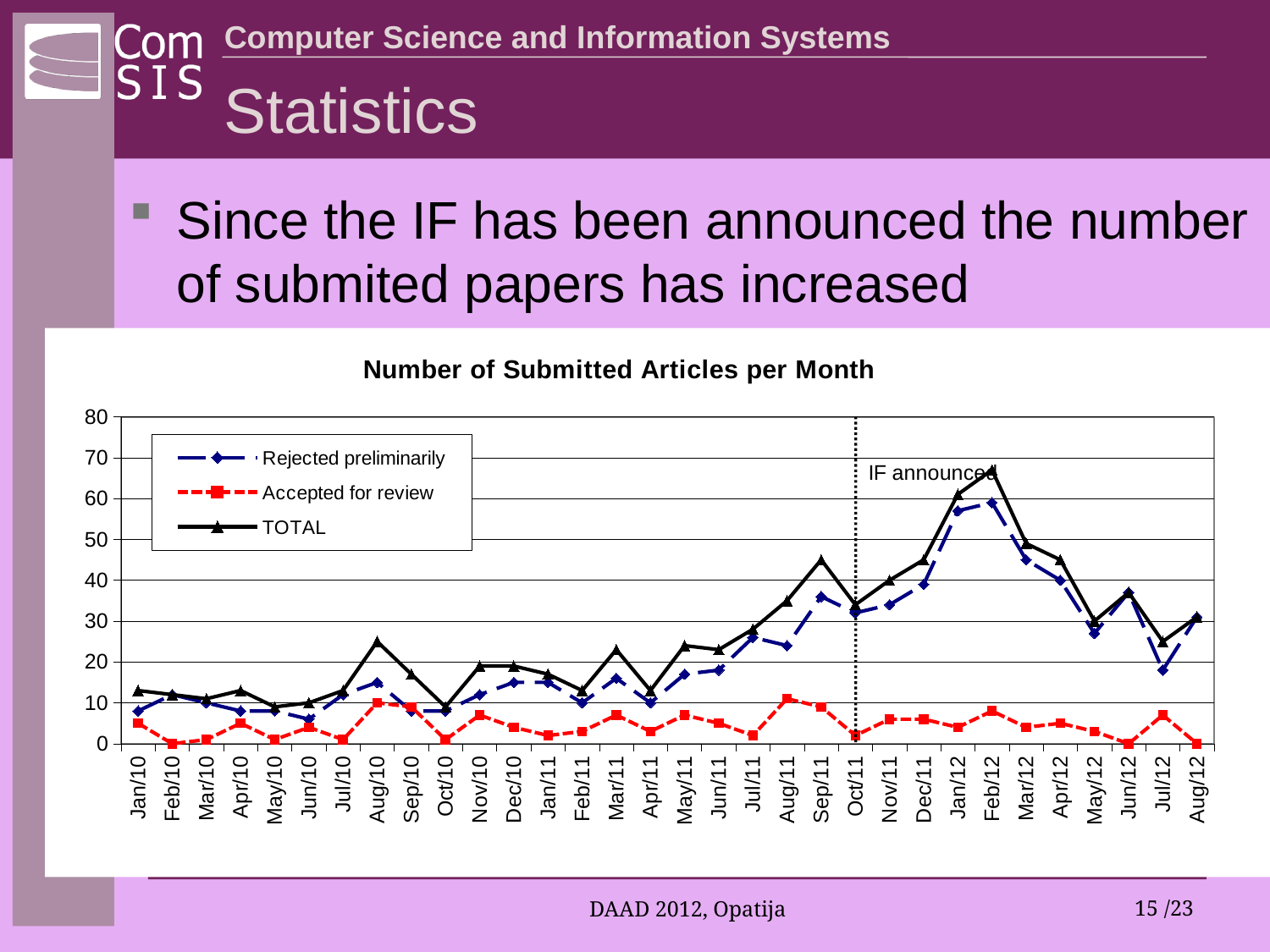
What is the title of the chart? Number of Submitted Articles per Month Is the Rejected preliminarily value for Jan/12 greater or less than 50? greater What kind of chart is shown on the slide? Line chart At which month is the vertical dotted line labelled 'IF announced' placed? Oct/11 Does the TOTAL series rise or fall from Oct/11 to Feb/12? rise Is the Accepted for review value for Feb/12 greater or less than 10? less Is the TOTAL value for Feb/12 greater or less than 60? greater How many series does the chart's legend list? 3 In which month does the TOTAL series reach its highest value? Feb/12 Which is larger, the TOTAL value for Feb/12 or the TOTAL value for Sep/11? Feb/12 How many months are plotted along the x axis of the chart? 32